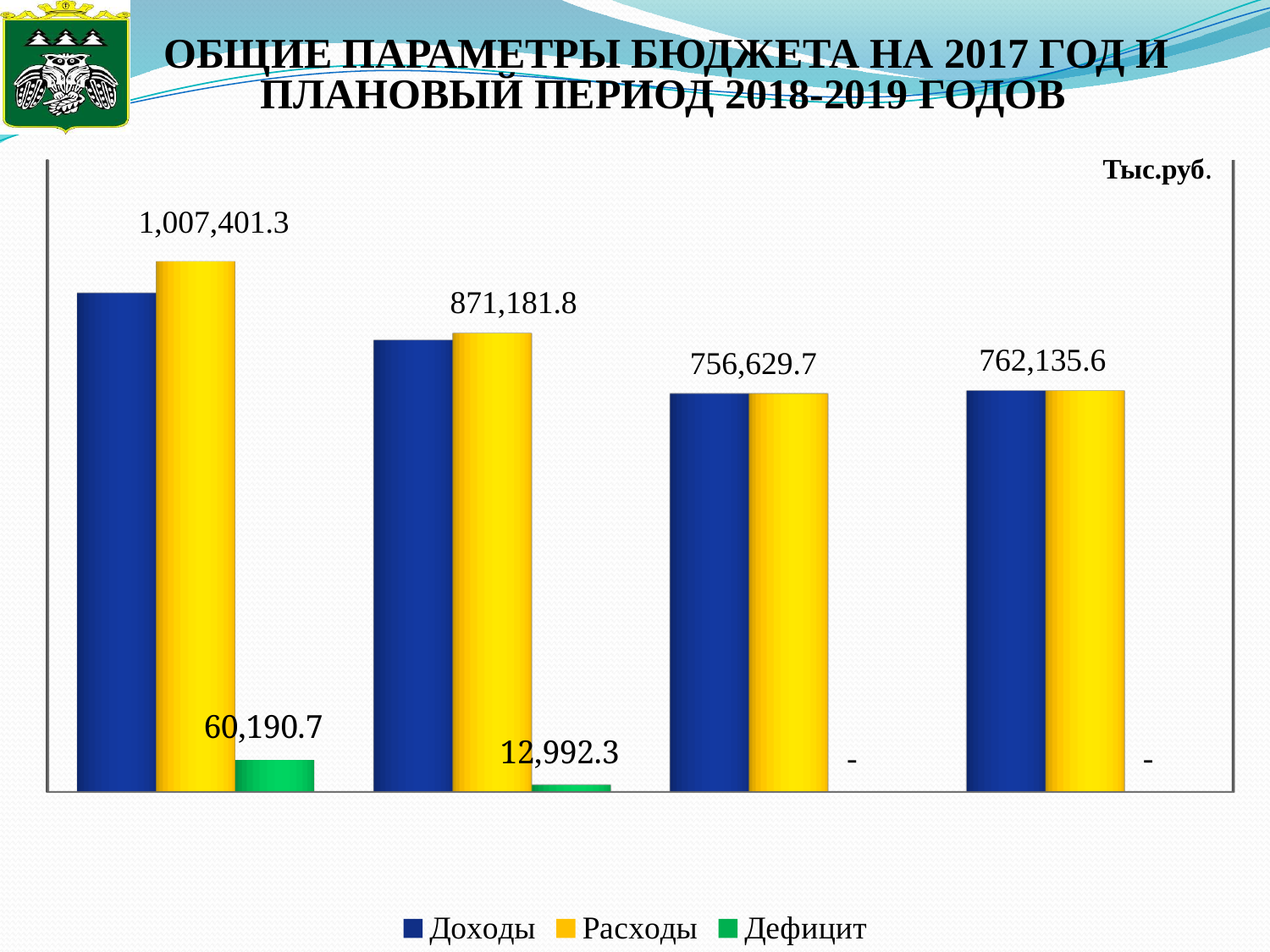
What unit is indicated in the top right corner of the chart? Тыс.руб. What is the value of Расходы for the third group of bars from the left? 756,629.7 Which is larger, the Расходы value of the third group or of the fourth group from the left? the fourth group What is the difference between the Расходы values of the first and second groups from the left? 136,219.5 What is the value of Расходы for the rightmost group of bars? 762,135.6 How many series does the legend list? 3 What is the value of Дефицит for the second group of bars from the left? 12,992.3 How many groups of bars are plotted along the x axis? 4 What is the value of Дефицит for the leftmost group of bars? 60,190.7 What is the value of Расходы for the leftmost group of bars? 1,007,401.3 What kind of chart is shown on the slide? bar chart Which group of bars has the highest Расходы value? the leftmost group